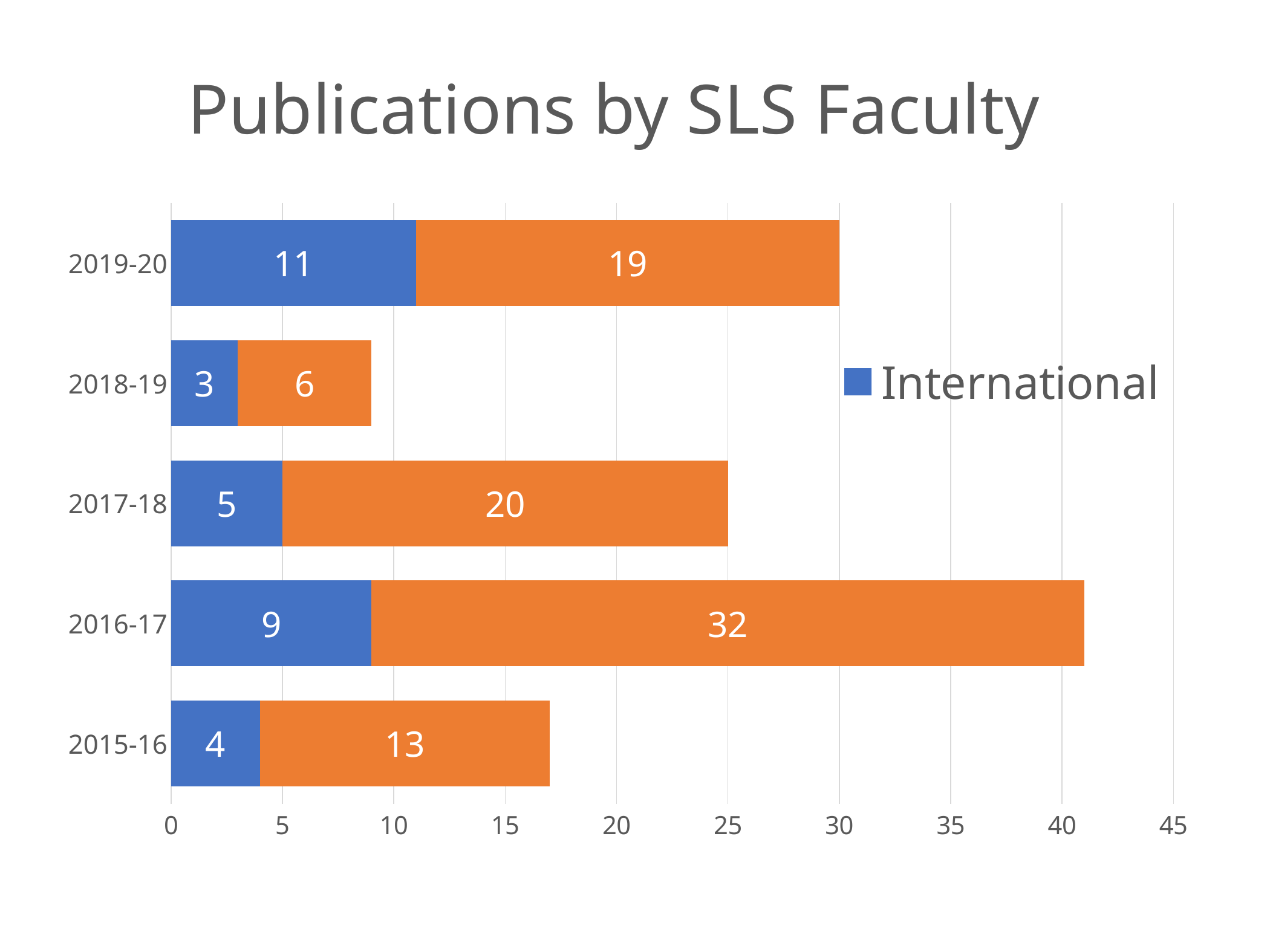
What is the International value for 2016-17? 9 What is the total of the stacked bar for 2019-20? 30 What is the International value for 2018-19? 3 How many year categories are shown on the chart? 5 Which year has the highest International value? 2019-20 Which year has the lowest International value? 2018-19 What is the total of the stacked bar for 2016-17? 41 What is the International value for 2019-20? 11 What is the title of the chart? Publications by SLS Faculty What is the difference between the International values for 2019-20 and 2017-18? 6 What type of chart is shown on the slide? Stacked bar chart Which is larger, the International value for 2016-17 or for 2015-16? 2016-17